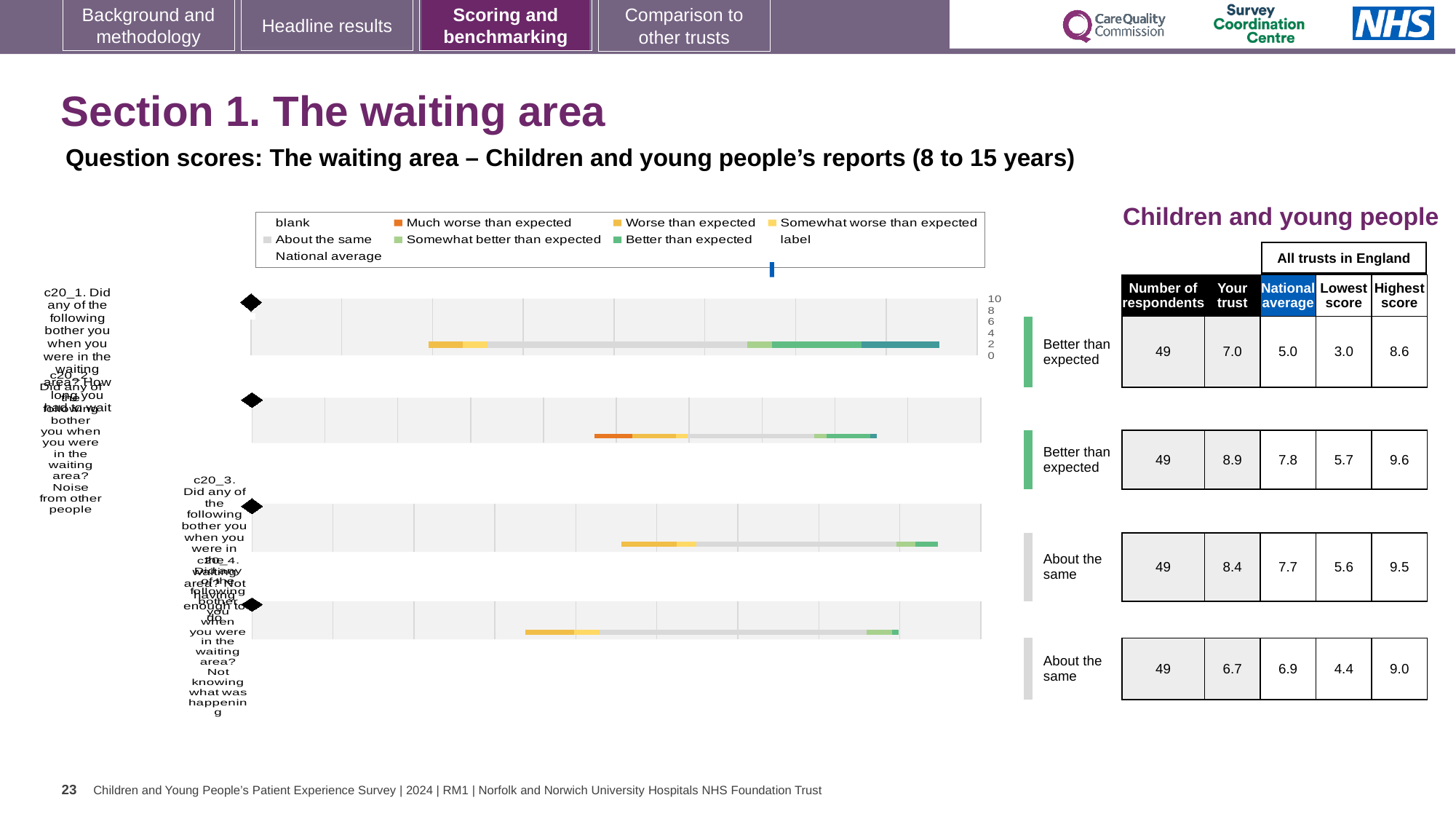
In the table beside the chart, what is the highest score for the third question row? 9.5 For the fourth question row, is the 'Your trust' score or the national average larger? national average How many horizontal bars (questions) are plotted in the chart? 4 How many respondents are listed for each question row in the table? 49 In the table beside the chart, what is the lowest score for the fourth (bottom) question row? 4.4 What is the difference between the 'Your trust' score and the national average for the first question row? 2.0 Which question row has the lowest 'Your trust' score in the table? the fourth row (6.7) In the table beside the chart, what is the 'Your trust' score for the first (top) question row? 7.0 What kind of chart is used to show the question scores on this slide? bar chart In the table beside the chart, what is the national average for the second question row? 7.8 What is the highest tick value shown on the chart's score axis? 10 Which question row has the highest 'Your trust' score in the table? the second row (8.9)